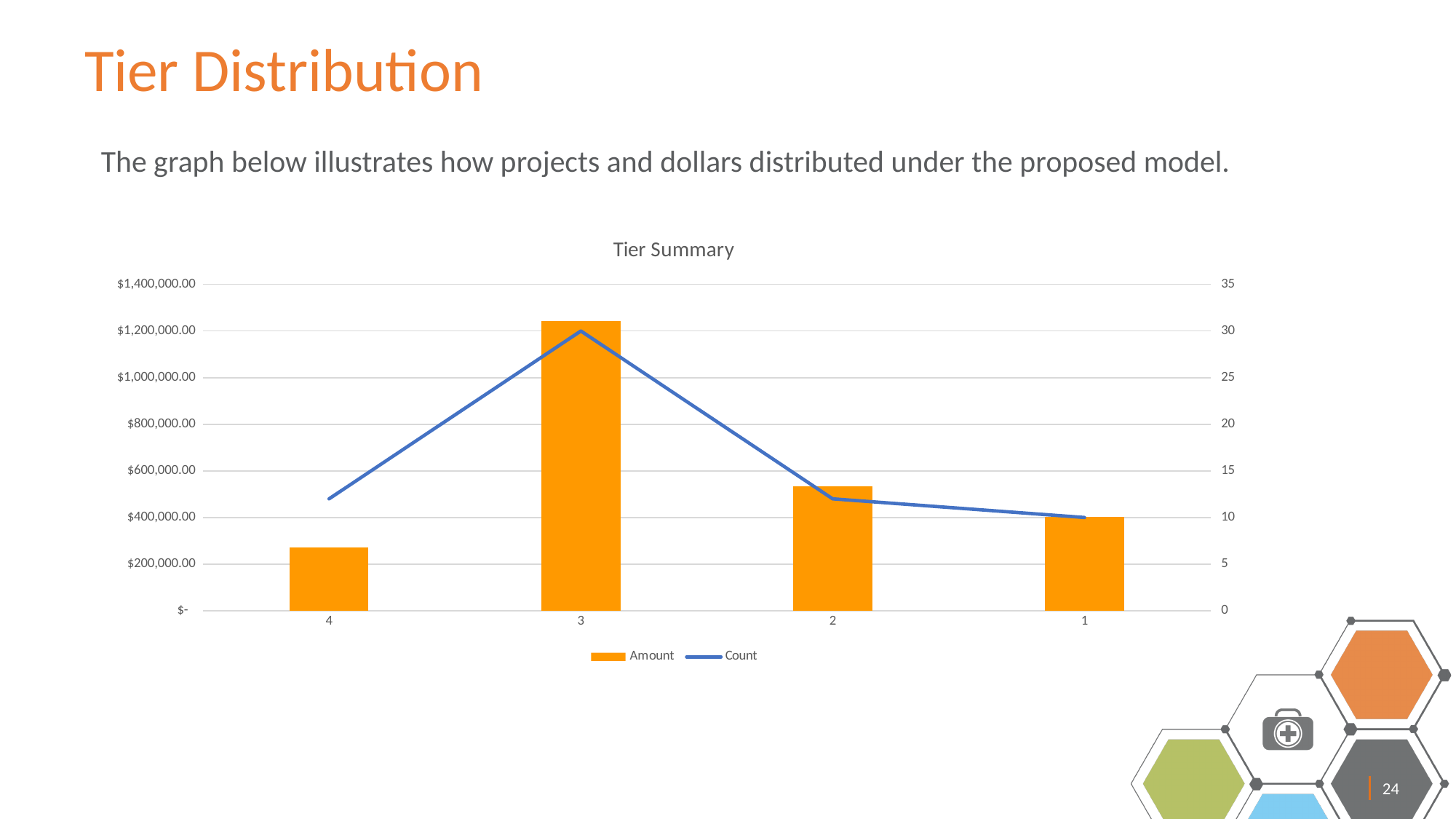
How many series does the legend of the Tier Summary chart list? 2 Is the Count for tier 4 greater or less than 15? less What is the Count value for tier 1 in the Tier Summary chart? 10 Is the Amount for tier 3 greater or less than $1,000,000.00? greater Which tier has the lowest Amount in the Tier Summary chart? 4 What kind of chart is shown on the slide? A bar chart combined with a line chart How many tier categories are shown on the x axis of the Tier Summary chart? 4 Which tier has the highest Amount in the Tier Summary chart? 3 Is the Amount for tier 4 greater or less than $400,000.00? less What is the title of the chart on the slide? Tier Summary What is the Count value for tier 3 in the Tier Summary chart? 30 Which has the larger Amount, tier 2 or tier 1? Tier 2